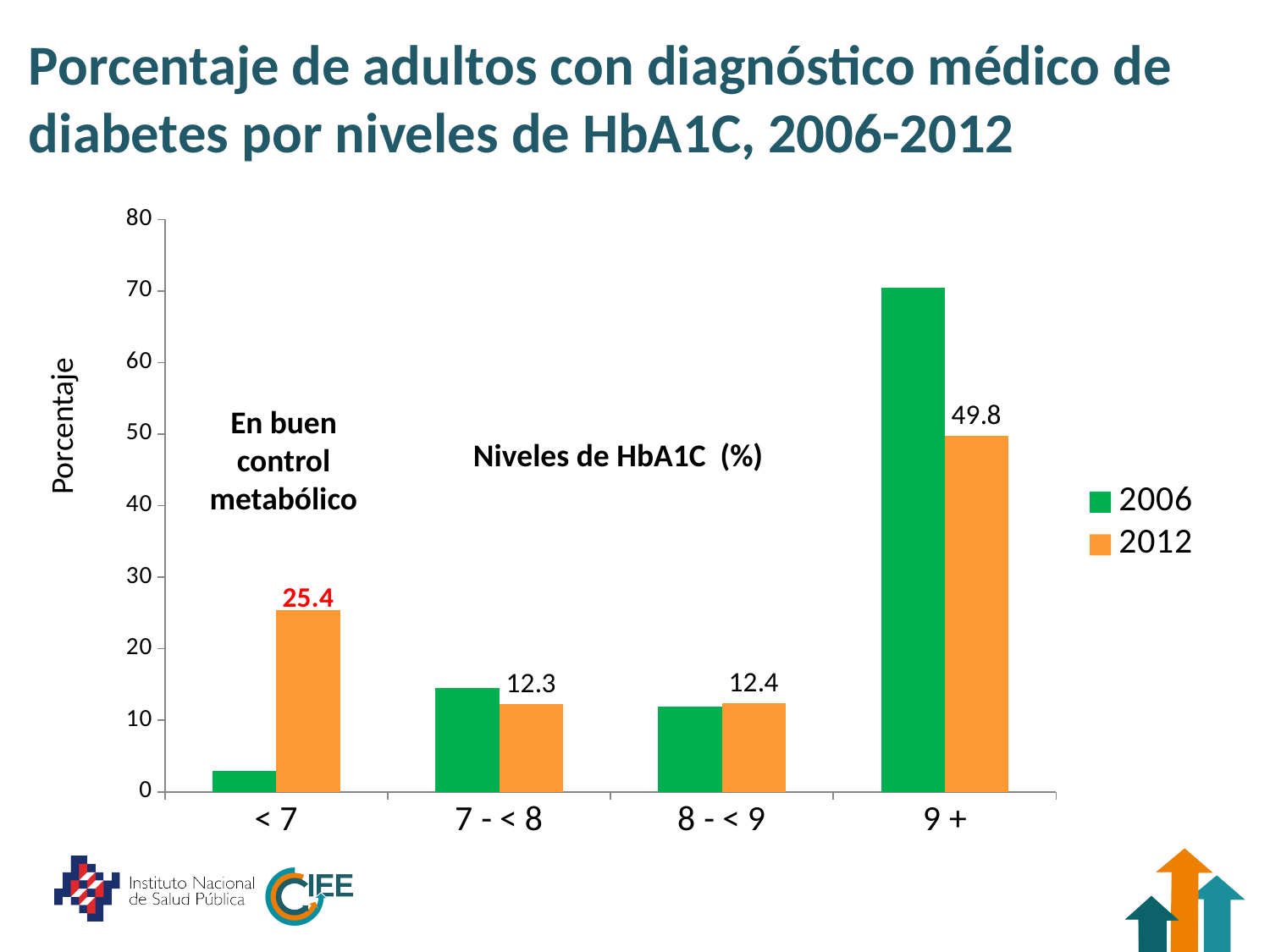
What is the value for 2012 in the < 7 category? 25.4 What is the difference between the 2012 values for 9 + and < 7? 24.4 What kind of chart is shown on the slide? bar chart In the 9 + category, which series has the larger value, 2006 or 2012? 2006 What is the value for 2012 in the 7 - < 8 category? 12.3 Is the value for 2006 in the < 7 category greater or less than 10? less Which HbA1C category has the lowest value for 2012? 7 - < 8 How many series does the legend list? 2 How many HbA1C categories are shown on the x axis? 4 Is the value for 2006 in the 9 + category greater or less than 60? greater What is the value for 2012 in the 9 + category? 49.8 Which HbA1C category has the highest value for 2012? 9 +